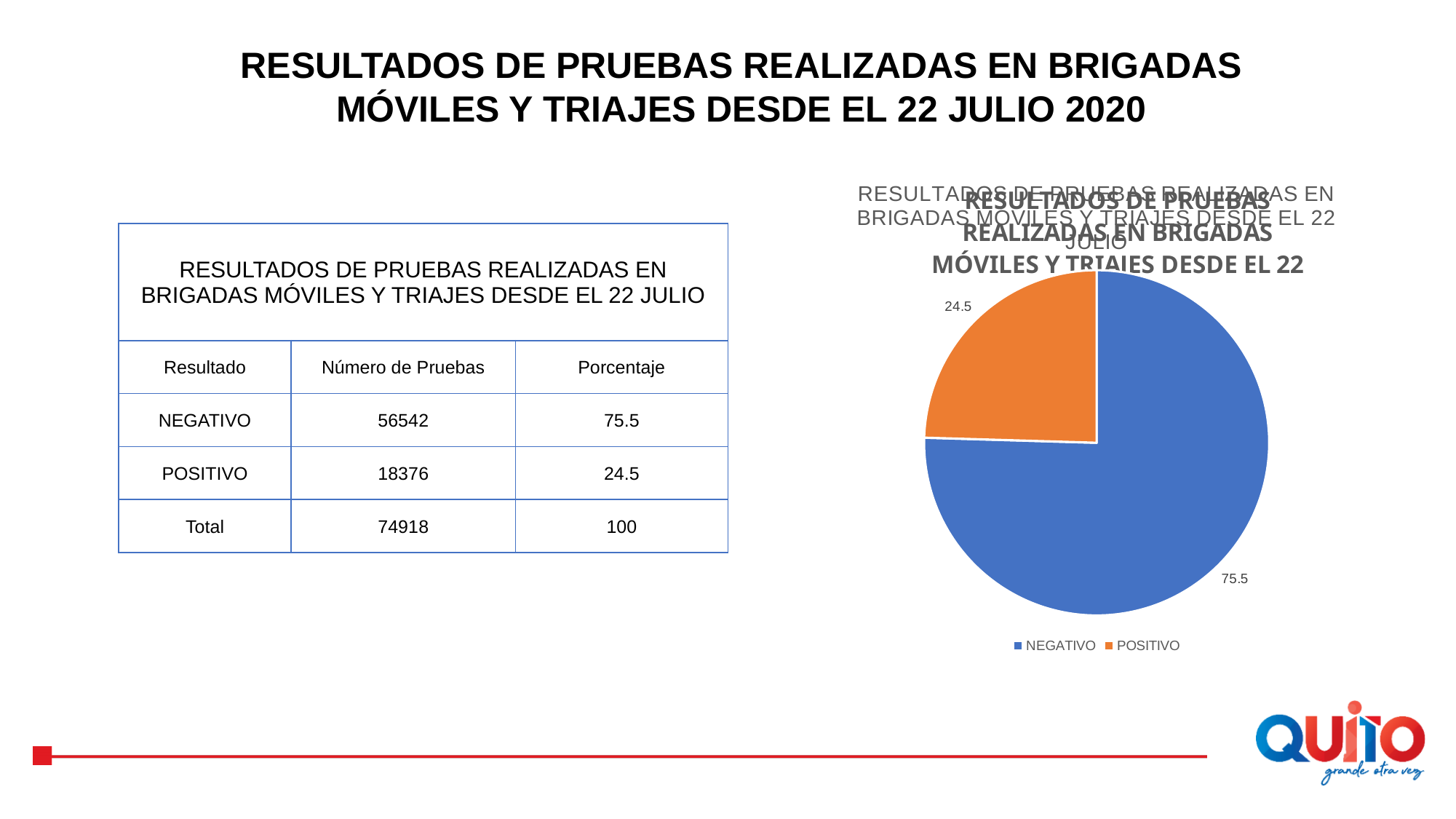
Which slice of the pie chart is the smallest? POSITIVO What type of chart is shown on the slide? pie chart Which is larger in the pie chart, NEGATIVO or POSITIVO? NEGATIVO How many slices does the pie chart have? 2 What colour is the NEGATIVO slice in the pie chart? blue What colour is the POSITIVO slice in the pie chart? orange Which slice of the pie chart is the largest? NEGATIVO How many entries does the legend of the pie chart list? 2 What is the value shown for the NEGATIVO slice of the pie chart? 75.5 What is the value shown for the POSITIVO slice of the pie chart? 24.5 What is the difference between the NEGATIVO and POSITIVO values in the pie chart? 51